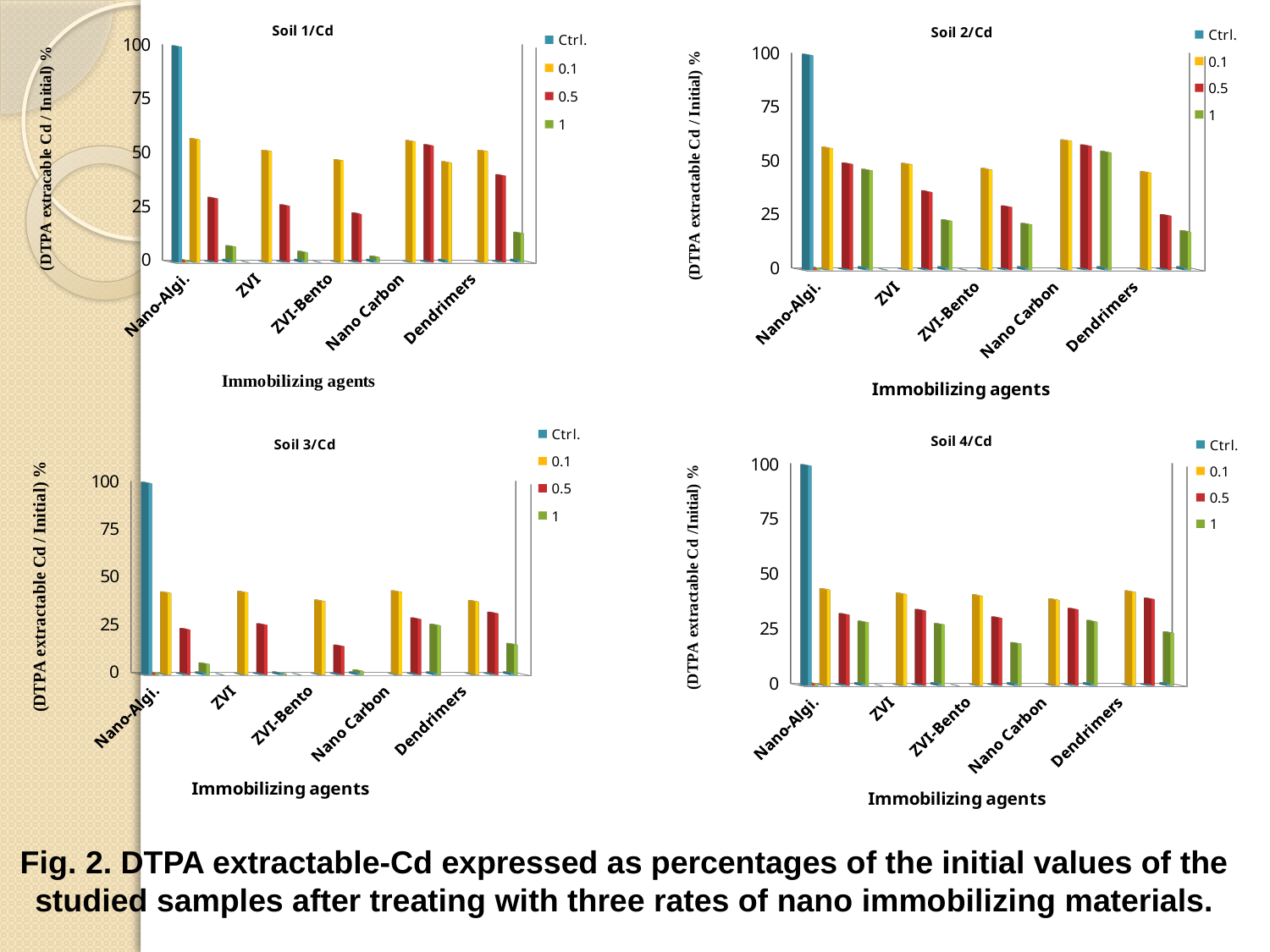
How many immobilizing agents are shown on the x axis of the Soil 3/Cd chart? 5 In the Soil 1/Cd chart, is the value for the 0.1 rate for ZVI greater or less than 75? less In the Soil 1/Cd chart, is the value for the 0.5 rate for Nano Carbon greater or less than 25? greater In the Soil 2/Cd chart, is the value for the 1 rate for Nano Carbon greater or less than 25? greater In the Soil 3/Cd chart, which immobilizing agent has the lowest value for the 0.5 rate? ZVI-Bento In the Soil 1/Cd chart, which has the larger value for the 0.5 rate: ZVI or Nano Carbon? Nano Carbon How many series does the legend of the Soil 2/Cd chart list? 4 In the Soil 2/Cd chart, which immobilizing agent has the highest value for the 1 rate? Nano Carbon What is the x-axis title of the Soil 4/Cd chart? Immobilizing agents What kind of chart is the Soil 1/Cd chart? bar chart